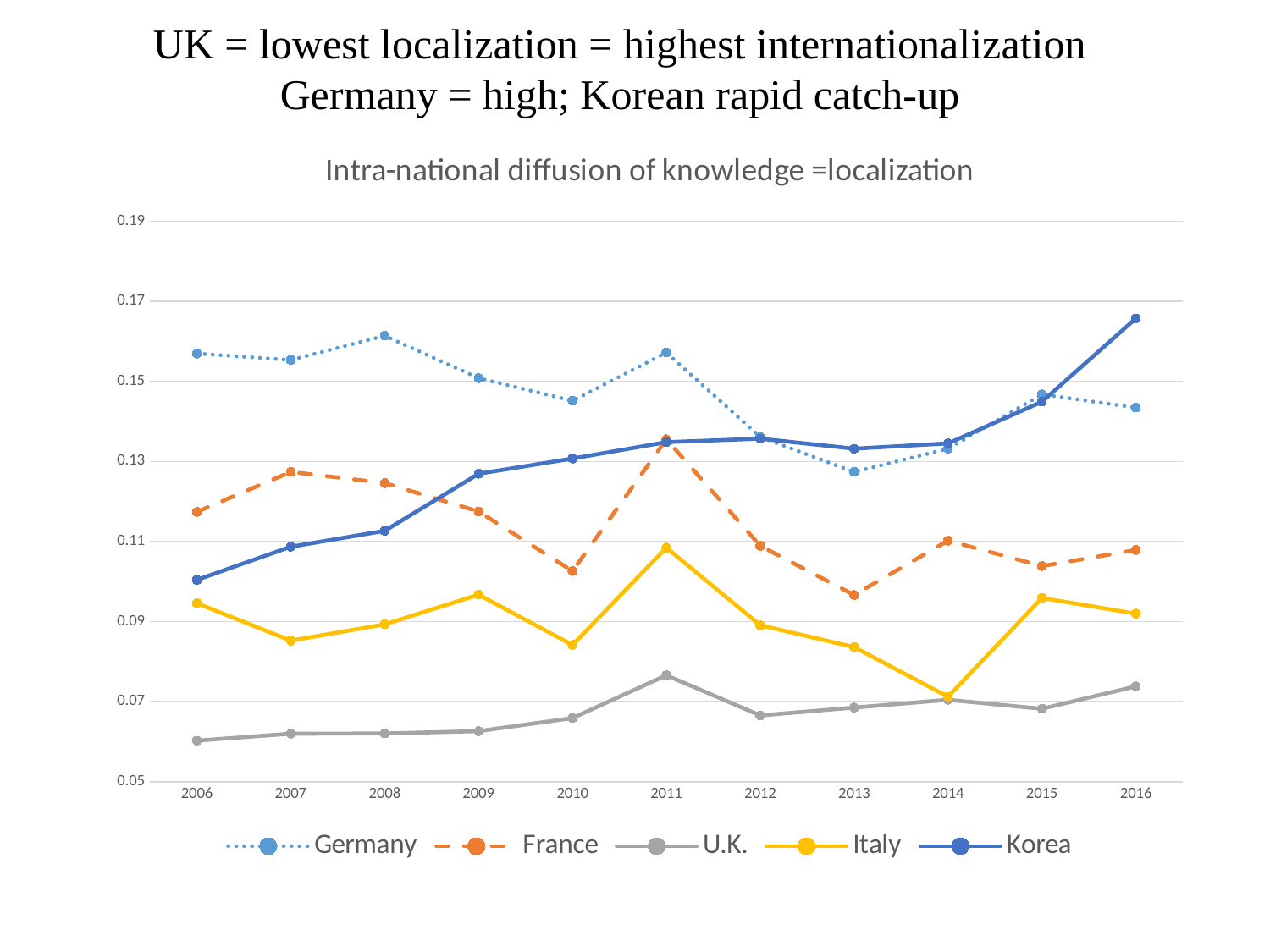
Is the value for Korea in 2016 greater or less than 0.15? greater How many years are shown on the x axis? 11 How many series does the legend list? 5 In 2006, which is larger, the value for Italy or the value for U.K.? Italy Is the value for France in 2013 greater or less than 0.11? less Which country has the highest value in 2006? Germany What kind of chart is shown on the slide? line chart What is the title of the chart? Intra-national diffusion of knowledge =localization Which country has the lowest value in 2016? U.K. Does the value for Korea generally rise or fall from 2006 to 2016? rise Which country has the highest value in 2016? Korea In 2016, which is larger, the value for Germany or the value for Korea? Korea